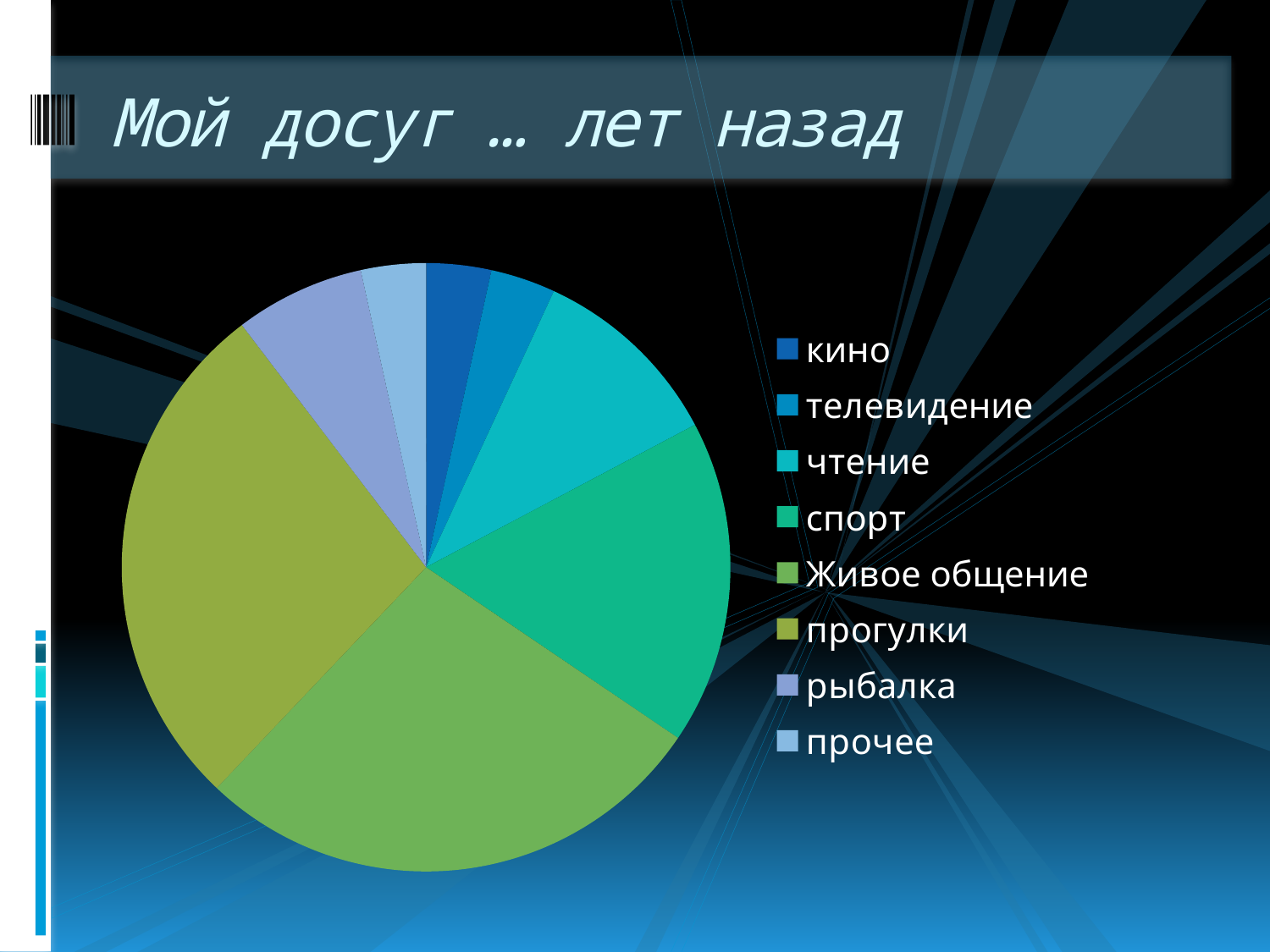
What kind of chart is shown on the slide? pie chart How many categories does the pie chart have? 8 Which slice is larger, Живое общение or рыбалка? Живое общение Which slice is larger, спорт or чтение? спорт Which slice is larger, прогулки or чтение? прогулки Which legend entry is listed first in the pie chart's legend? кино What is the title of the slide containing the pie chart? Мой досуг … лет назад